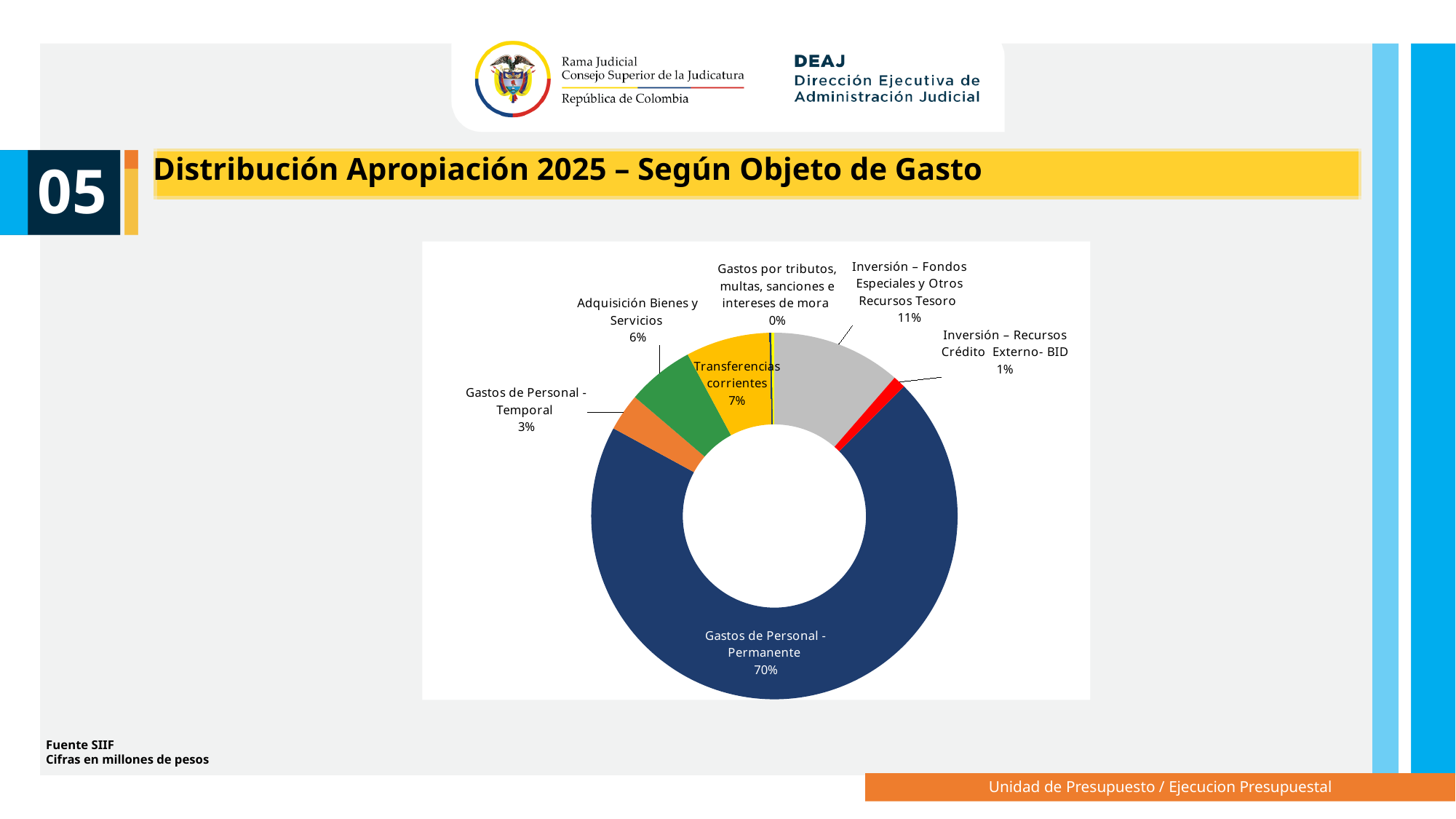
What share of the 2025 appropriation goes to Gastos de Personal - Permanente? 70% How many categories are shown in the chart? 8 How many percentage points larger is Gastos de Personal - Permanente than Inversión – Fondos Especiales y Otros Recursos Tesoro? 59 percentage points What percentage is shown for Inversión – Fondos Especiales y Otros Recursos Tesoro? 11% What kind of chart is shown on the slide? Doughnut (pie) chart What percentage is shown for Adquisición Bienes y Servicios? 6% Which category has the largest share of the chart? Gastos de Personal - Permanente What percentage is shown for Gastos de Personal - Temporal? 3% What percentage is shown for Transferencias corrientes? 7% Which is larger: Transferencias corrientes or Adquisición Bienes y Servicios? Transferencias corrientes What is the title of the slide containing the chart? Distribución Apropiación 2025 – Según Objeto de Gasto